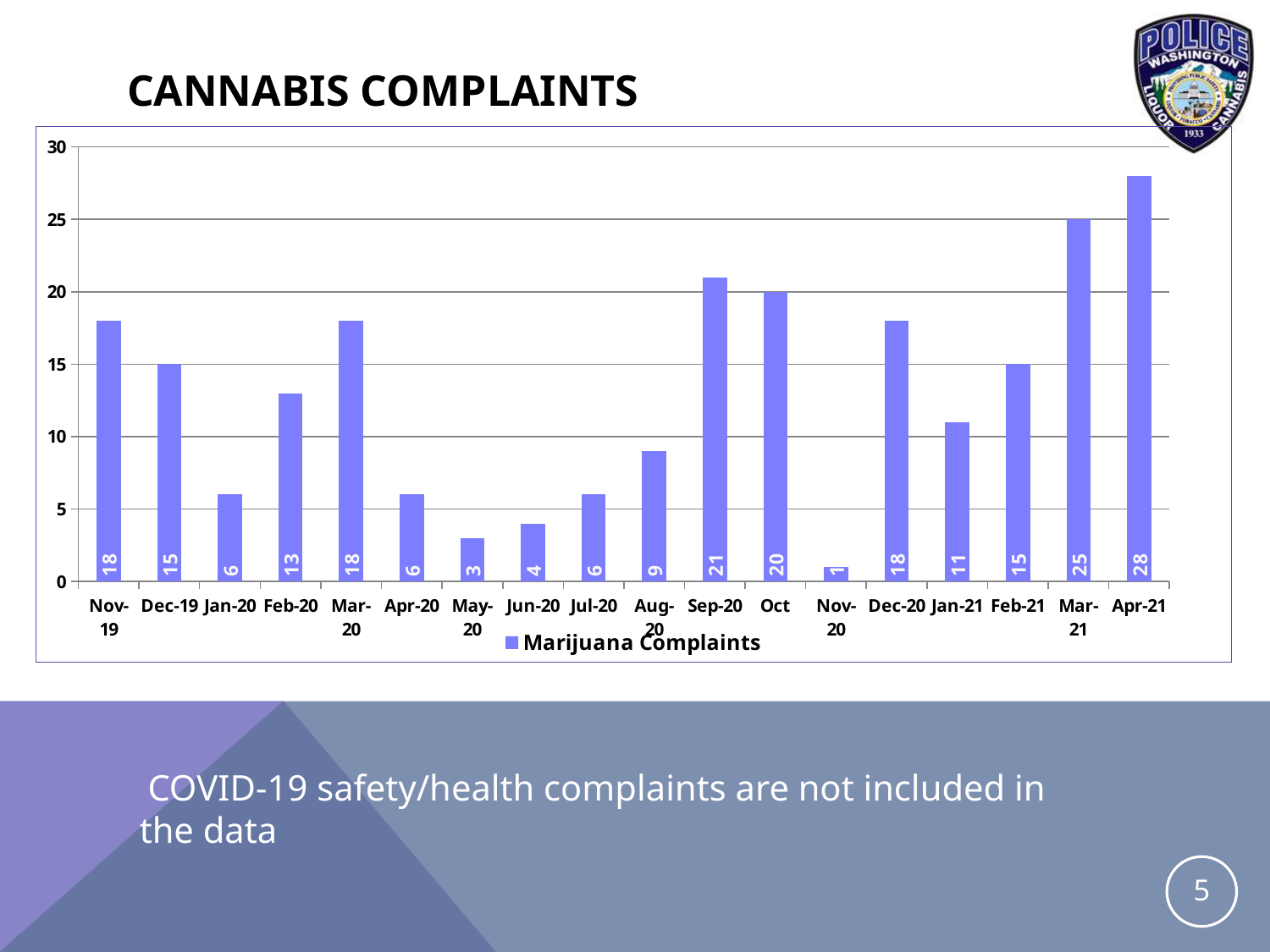
What is the value for Nov-20? 1 How many series does the legend list? 1 Which month has the lowest number of marijuana complaints? Nov-20 What is the value for Apr-21? 28 What kind of chart is shown? bar chart What is the title of the chart? CANNABIS COMPLAINTS What is the value for Sep-20? 21 Which month has the highest number of marijuana complaints? Apr-21 Is the value for Mar-21 greater or less than 20? greater How many months are shown on the x axis? 18 What is the difference between the values for Apr-21 and Mar-21? 3 Which is larger, the value for Sep-20 or the value for Oct? Sep-20